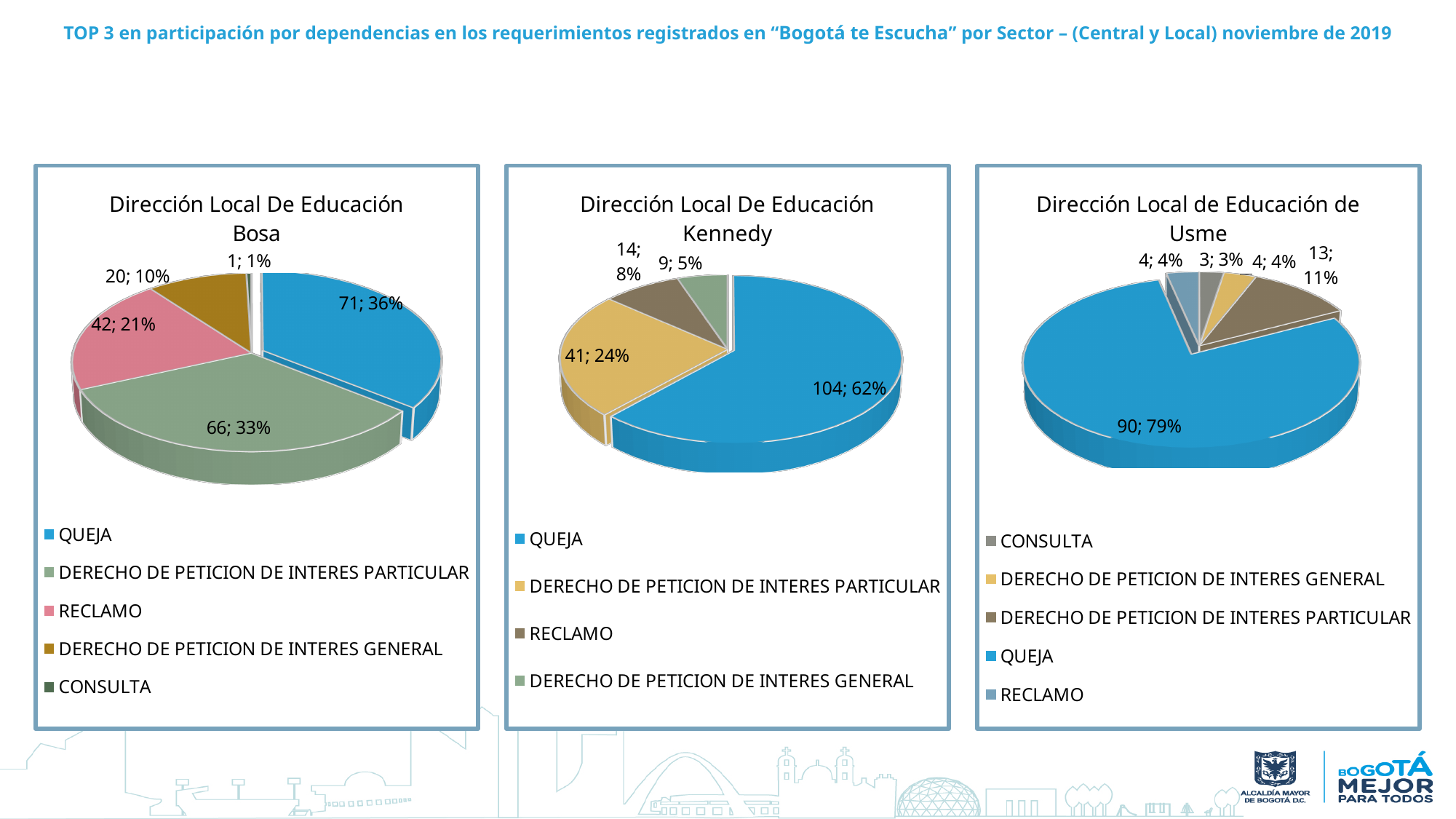
In the Dirección Local De Educación Bosa chart, which category has the lowest value? CONSULTA How many categories does the Dirección Local De Educación Kennedy chart show? 4 In the Dirección Local De Educación Bosa chart, what is the difference between QUEJA and DERECHO DE PETICION DE INTERES PARTICULAR? 5 In the Dirección Local de Educación de Usme chart, which is larger, DERECHO DE PETICION DE INTERES PARTICULAR or DERECHO DE PETICION DE INTERES GENERAL? DERECHO DE PETICION DE INTERES PARTICULAR In the Dirección Local de Educación de Usme chart, what is the value for QUEJA? 90; 79% In the Dirección Local De Educación Bosa chart, what is the value for QUEJA? 71; 36% In the Dirección Local De Educación Bosa chart, what is the value for RECLAMO? 42; 21% What type of chart is the Dirección Local De Educación Bosa chart? Pie chart In the Dirección Local De Educación Kennedy chart, what share of the pie does RECLAMO represent? 8% In the Dirección Local De Educación Kennedy chart, which category has the highest value? QUEJA In the Dirección Local De Educación Kennedy chart, what is the value for DERECHO DE PETICION DE INTERES PARTICULAR? 41; 24% In the Dirección Local de Educación de Usme chart, what is the value for DERECHO DE PETICION DE INTERES PARTICULAR? 13; 11%